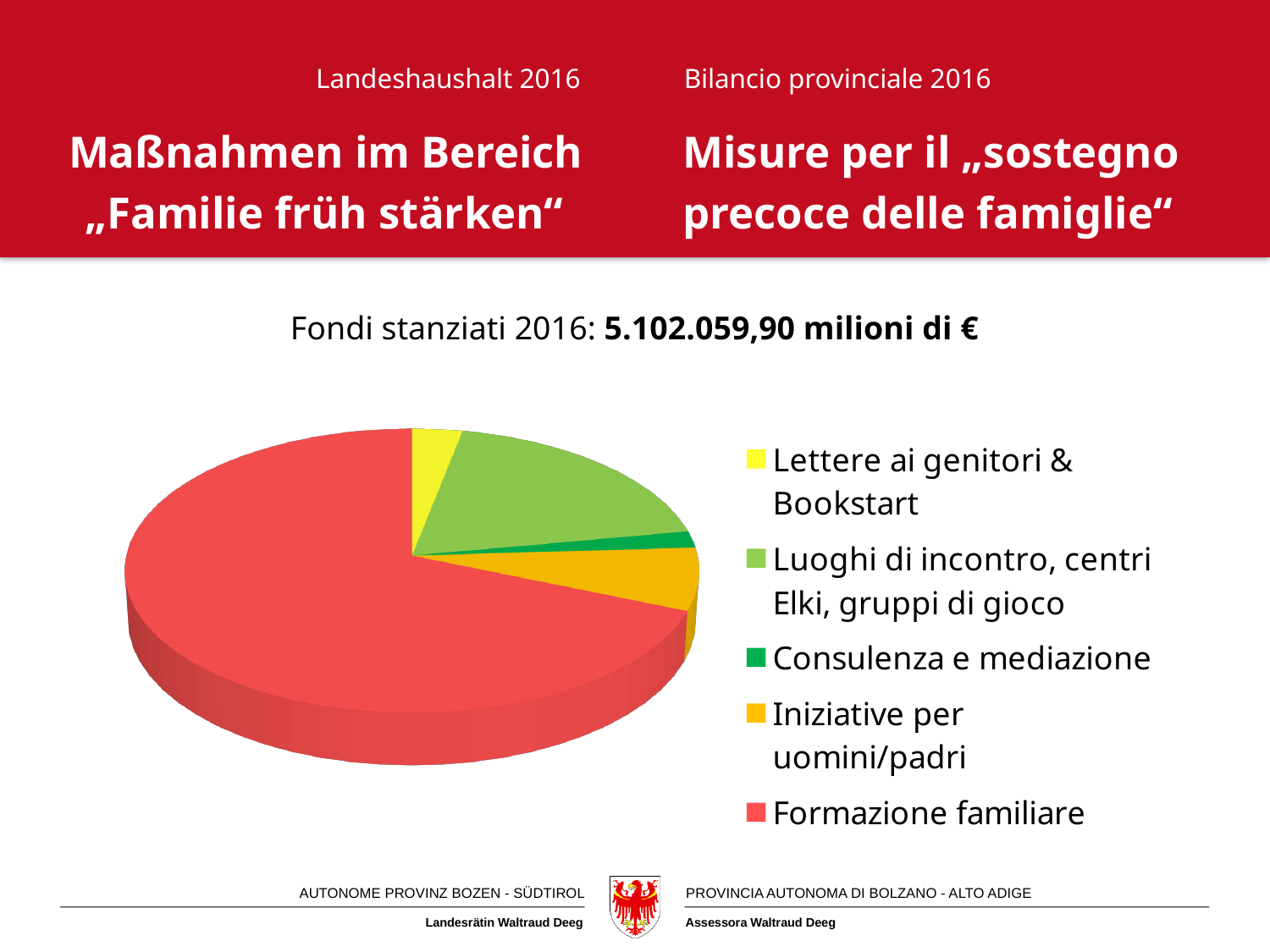
Which colour represents Formazione familiare in the pie chart? red Which slice is larger: Lettere ai genitori & Bookstart or Consulenza e mediazione? Lettere ai genitori & Bookstart Which slice is larger: Luoghi di incontro, centri Elki, gruppi di gioco or Iniziative per uomini/padri? Luoghi di incontro, centri Elki, gruppi di gioco Which category has the smallest slice of the pie chart? Consulenza e mediazione What kind of chart is shown on the slide? pie chart Which category has the largest slice of the pie chart? Formazione familiare How many slices does the pie chart have? 5 Which legend entry is shown in yellow? Lettere ai genitori & Bookstart How many entries does the legend of the pie chart list? 5 Which slice is larger: Formazione familiare or Lettere ai genitori & Bookstart? Formazione familiare Does the Formazione familiare slice make up more or less than half of the pie? more